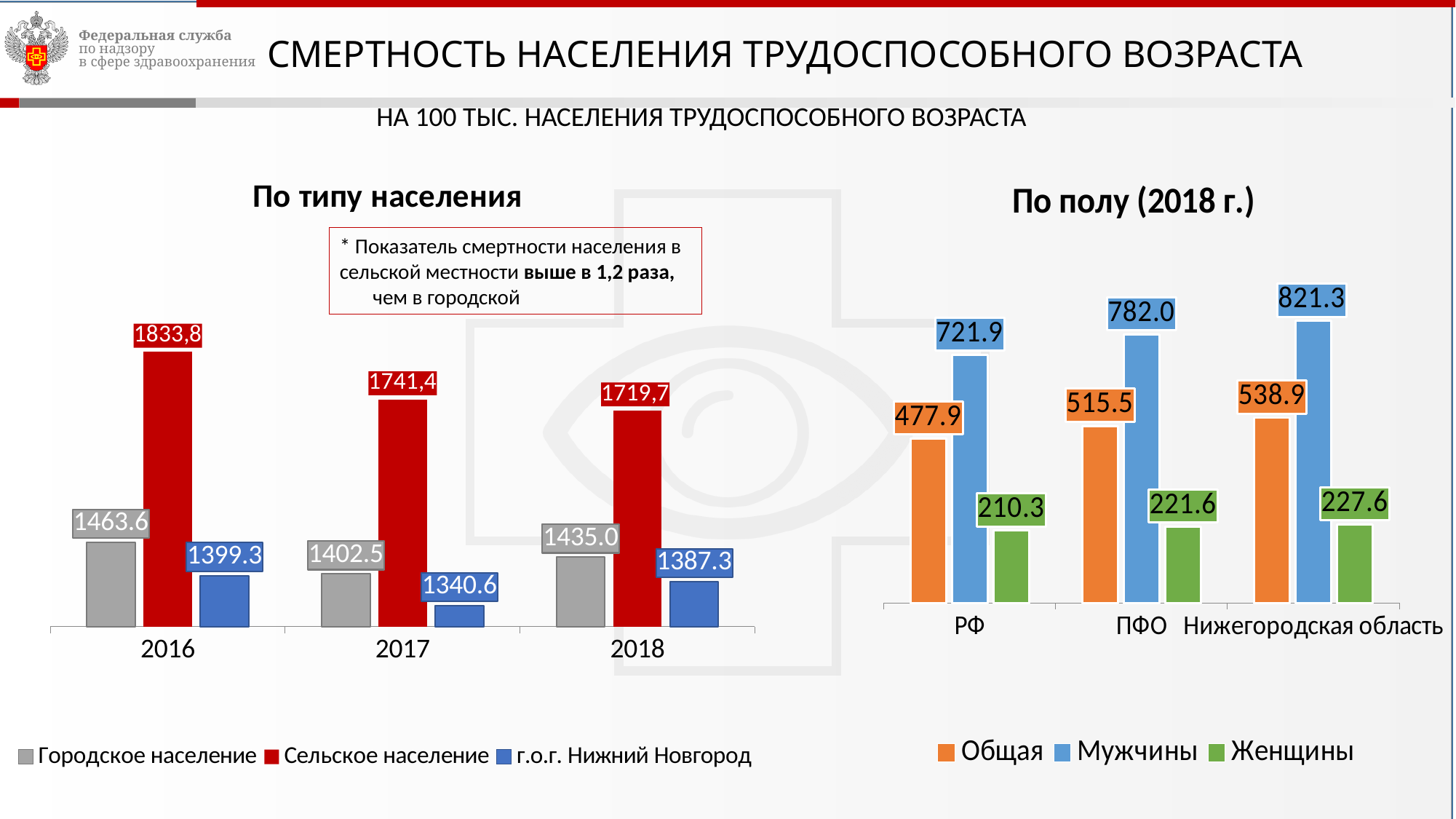
In the chart 'По полу (2018 г.)', how many series does the legend list? 3 In the chart 'По типу населения', does the value for Сельское население rise or fall from 2016 to 2018? fall In the chart 'По типу населения', what is the value for Сельское население in 2016? 1833,8 What kind of chart is 'По типу населения'? bar chart In the chart 'По полу (2018 г.)', what is the difference between Мужчины and Женщины in Нижегородская область? 593.7 In the chart 'По полу (2018 г.)', which region has the highest value for Общая? Нижегородская область In the chart 'По типу населения', what is the difference between Городское население and г.о.г. Нижний Новгород in 2016? 64.3 In the chart 'По типу населения', what is the value for г.о.г. Нижний Новгород in 2017? 1340.6 In the chart 'По типу населения', what is the value for Городское население in 2018? 1435.0 In the chart 'По полу (2018 г.)', what is the value for Мужчины in ПФО? 782.0 In the chart 'По типу населения', which year has the highest value for Сельское население? 2016 In the chart 'По полу (2018 г.)', what is the value for Женщины in РФ? 210.3